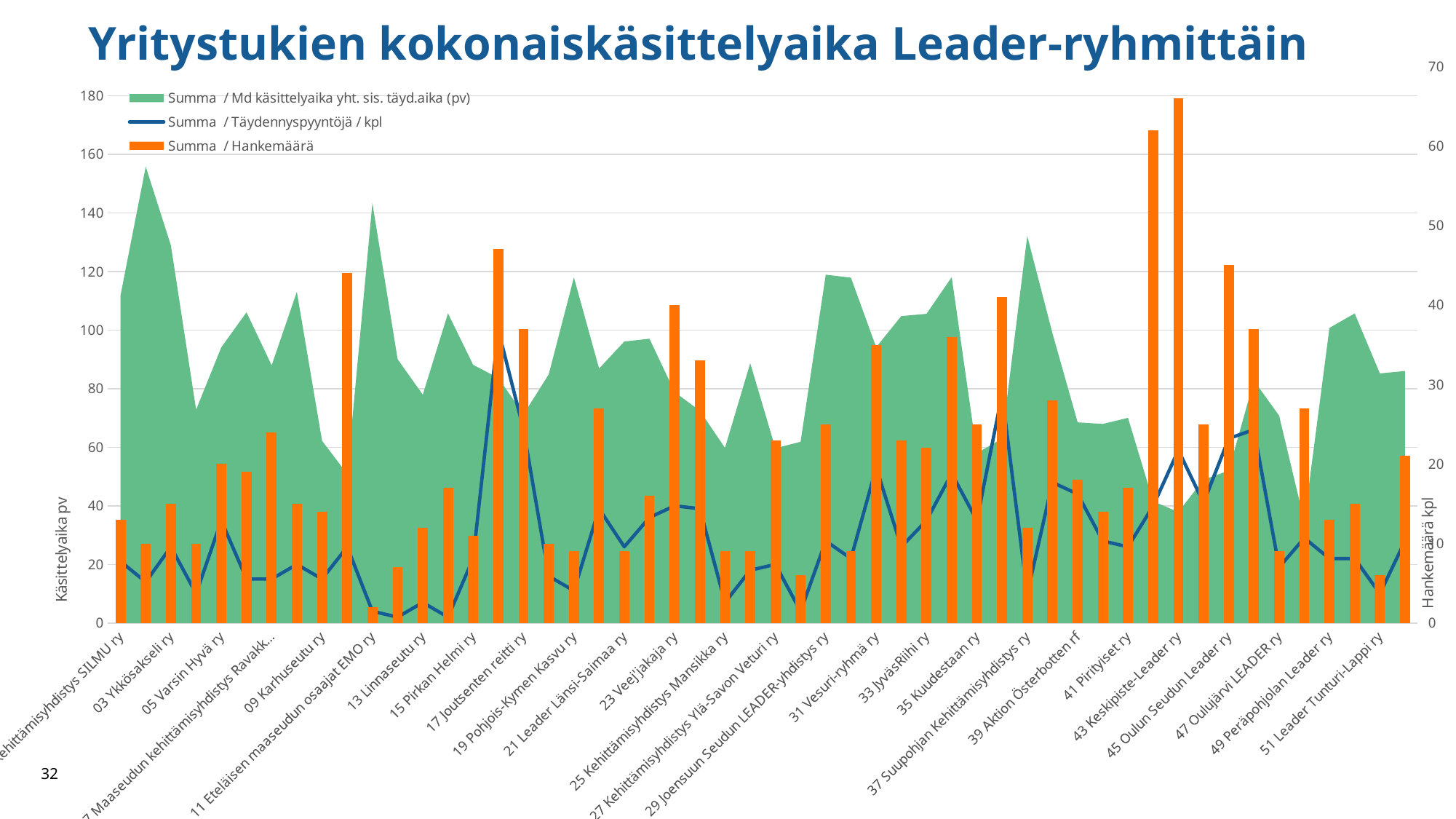
Is the highest Md käsittelyaika value greater or less than 140? greater What kind of chart is this? Combination chart with an area, a line and bars Is the Hankemäärä value for 43 Keskipiste-Leader ry greater or less than 70? less What is the title of the chart? Yritystukien kokonaiskäsittelyaika Leader-ryhmittäin Is the highest Hankemäärä value greater or less than 60? greater What is the maximum value shown on the left vertical axis? 180 Which series is plotted as orange bars? Summa / Hankemäärä How many series does the legend list? 3 Which category has the highest Hankemäärä bar? 43 Keskipiste-Leader ry